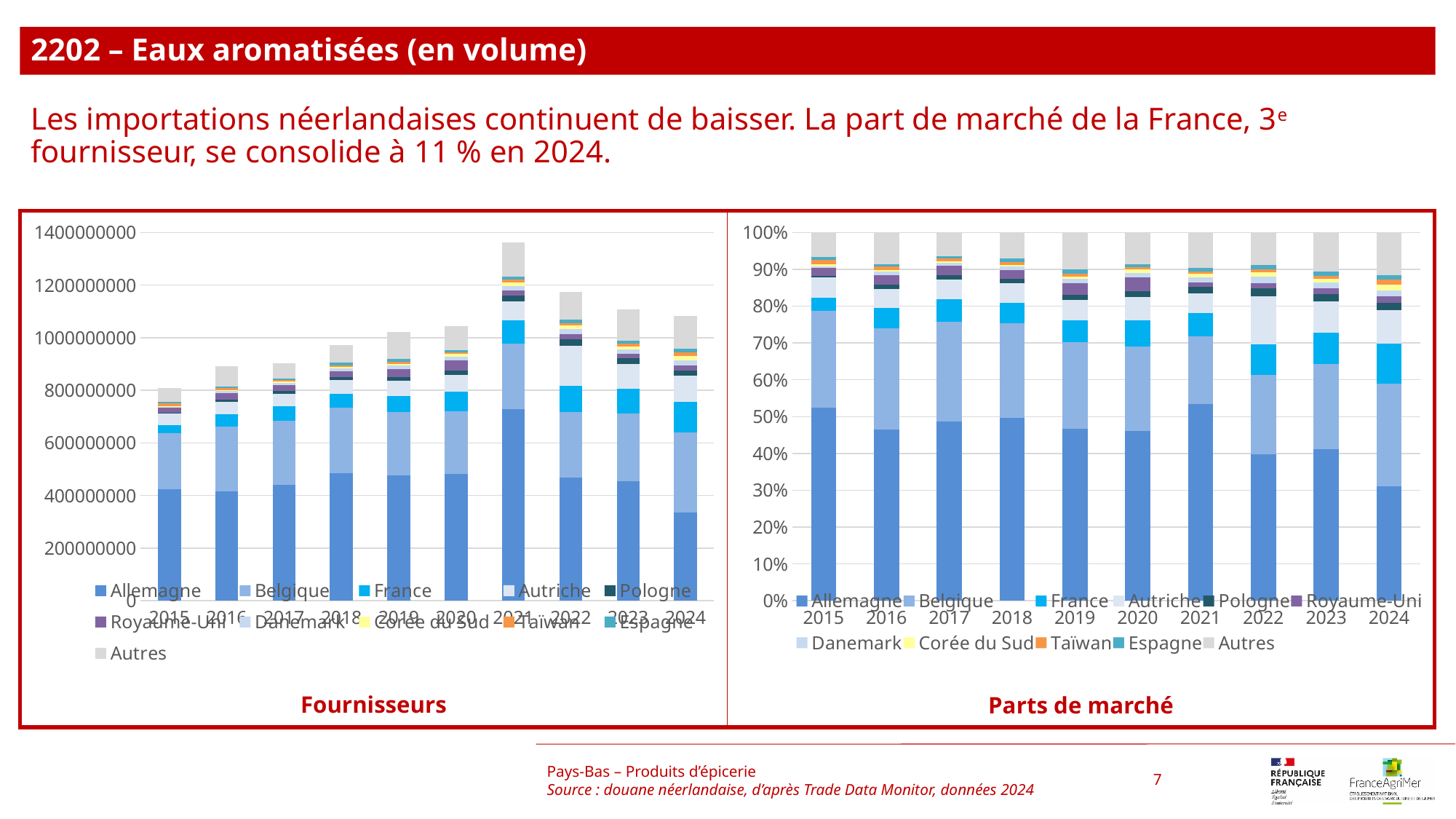
In the 'Fournisseurs' chart, which total bar is larger, 2021 or 2024? 2021 What kind of chart is the 'Fournisseurs' chart on the left? Stacked bar chart In the 'Fournisseurs' chart, which year has the lowest total bar? 2015 What is the title shown under the right-hand chart? Parts de marché In the 'Parts de marché' chart, is the share of Allemagne in 2024 greater or less than 40%? less In the 'Fournisseurs' chart, is the total for 2015 greater or less than 1000000000? less In the 'Fournisseurs' chart, which year has the highest total bar? 2021 How many series does the legend of the 'Fournisseurs' chart list? 11 In the 'Parts de marché' chart, is the share of Allemagne in 2021 greater or less than 50%? greater In the 'Fournisseurs' chart, do the total bars rise or fall from 2021 to 2024? fall How many years are shown on the x axis of the 'Parts de marché' chart? 10